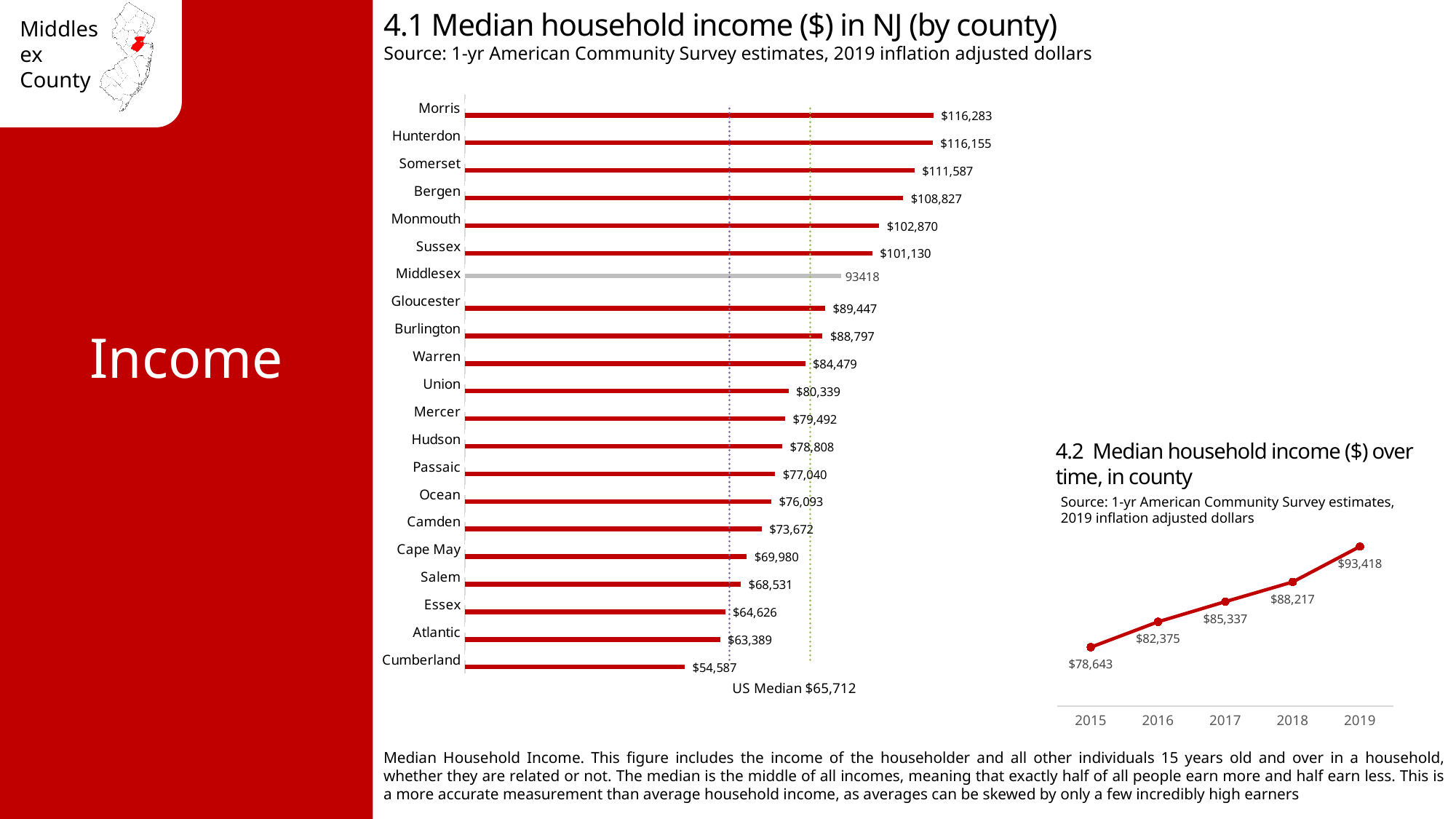
In chart 4.1 (Median household income in NJ by county), what is the median household income for Morris? $116,283 In chart 4.1 (Median household income in NJ by county), how many counties are shown? 21 In chart 4.1 (Median household income in NJ by county), what is the difference between the median household income of Bergen and Essex? $44,201 In chart 4.2 (Median household income over time, in county), what is the difference between the 2019 and 2015 values? $14,775 In chart 4.2 (Median household income over time, in county), does the median household income rise or fall from 2015 to 2019? rise In chart 4.2 (Median household income over time, in county), what was the median household income in 2017? $85,337 In chart 4.1 (Median household income in NJ by county), which county has the lowest median household income? Cumberland What type of chart is chart 4.2 (Median household income over time, in county)? line chart In chart 4.1 (Median household income in NJ by county), what US Median value is noted on the chart? $65,712 In chart 4.1 (Median household income in NJ by county), which county has a higher median household income, Somerset or Monmouth? Somerset In chart 4.1 (Median household income in NJ by county), what is the median household income for Middlesex? 93418 In chart 4.1 (Median household income in NJ by county), which county has the highest median household income? Morris